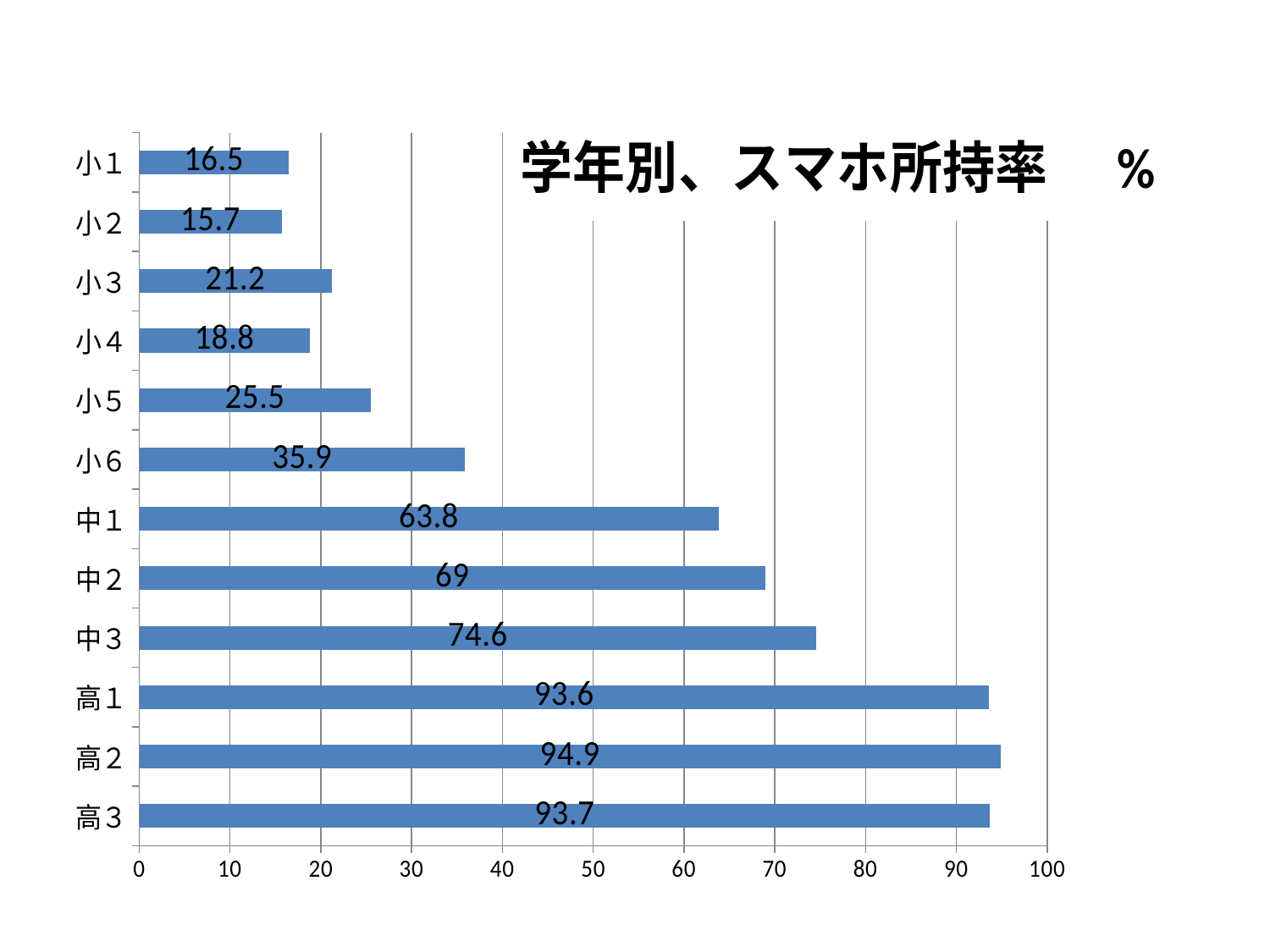
What is the difference between the values for 高２ and 高３? 1.2 Is the value for 小６ greater or less than 30? greater What is the title of the chart? 学年別、スマホ所持率 ％ How many categories are shown in the chart? 12 What is the value for 中２? 69 What kind of chart is shown on the slide? bar chart Which category has the lowest value? 小２ What is the value for 小１? 16.5 Which is larger, the value for 小３ or the value for 小４? 小３ Which category has the highest value? 高２ What is the difference between the values for 中３ and 中１? 10.8 What is the value for 高１? 93.6